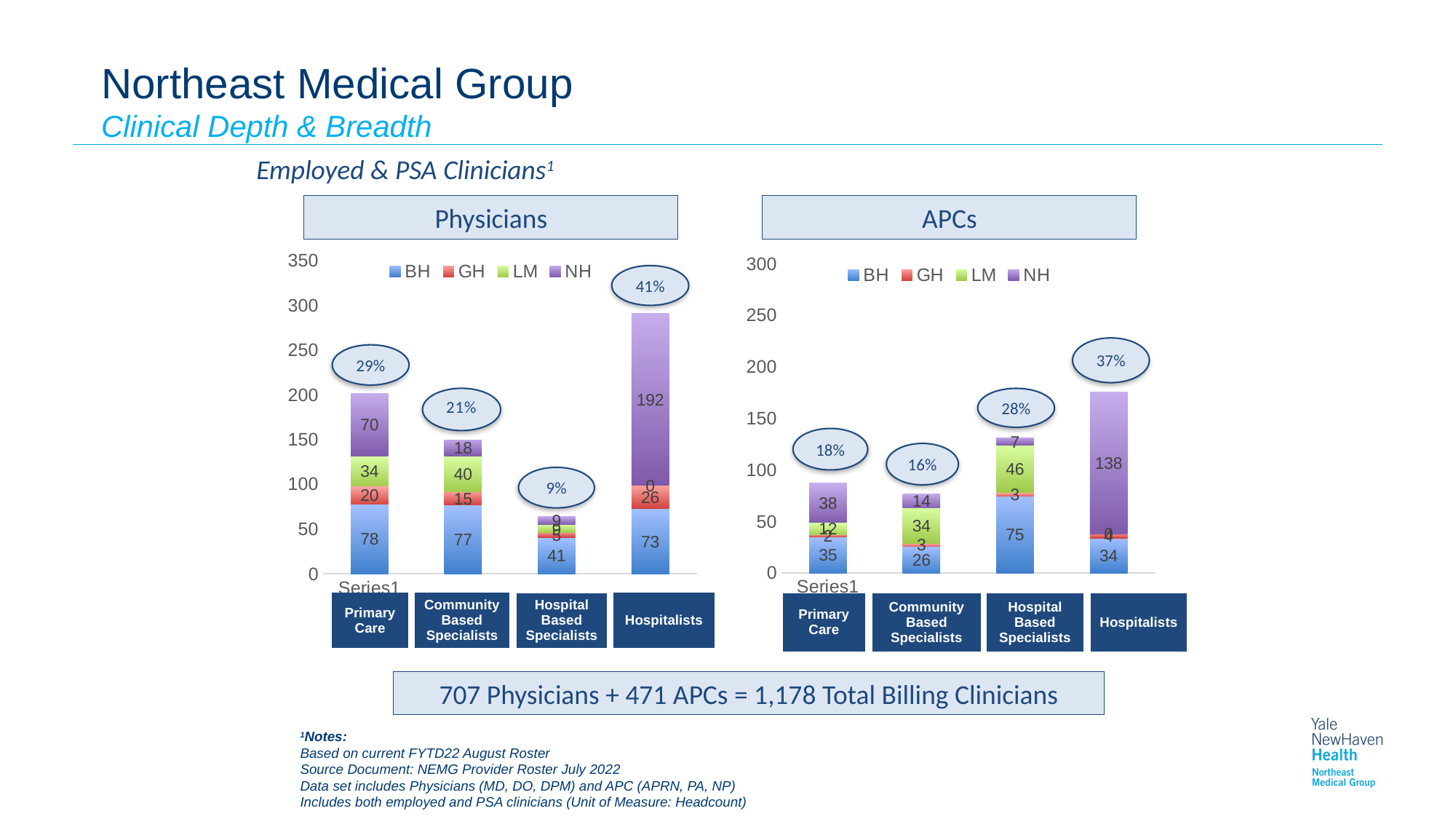
In the Physicians chart, what is the total of the stacked bar for Primary Care? 202 In the APCs chart, what is the total of the stacked bar for Hospital Based Specialists? 131 How many series does the legend of the Physicians chart list? 4 In the APCs chart, what is the NH value for Hospitalists? 138 In the APCs chart, what is the LM value for Hospital Based Specialists? 46 In the APCs chart, which has the larger BH value: Hospital Based Specialists or Primary Care? Hospital Based Specialists In the Physicians chart, what is the difference between the NH value for Primary Care and the NH value for Community Based Specialists? 52 What kind of chart is the APCs chart? Stacked bar chart In the Physicians chart, which category has the tallest stacked bar? Hospitalists In the Physicians chart, what is the BH value for Primary Care? 78 How many categories are shown along the x axis of the APCs chart? 4 In the Physicians chart, what is the NH value for Hospitalists? 192